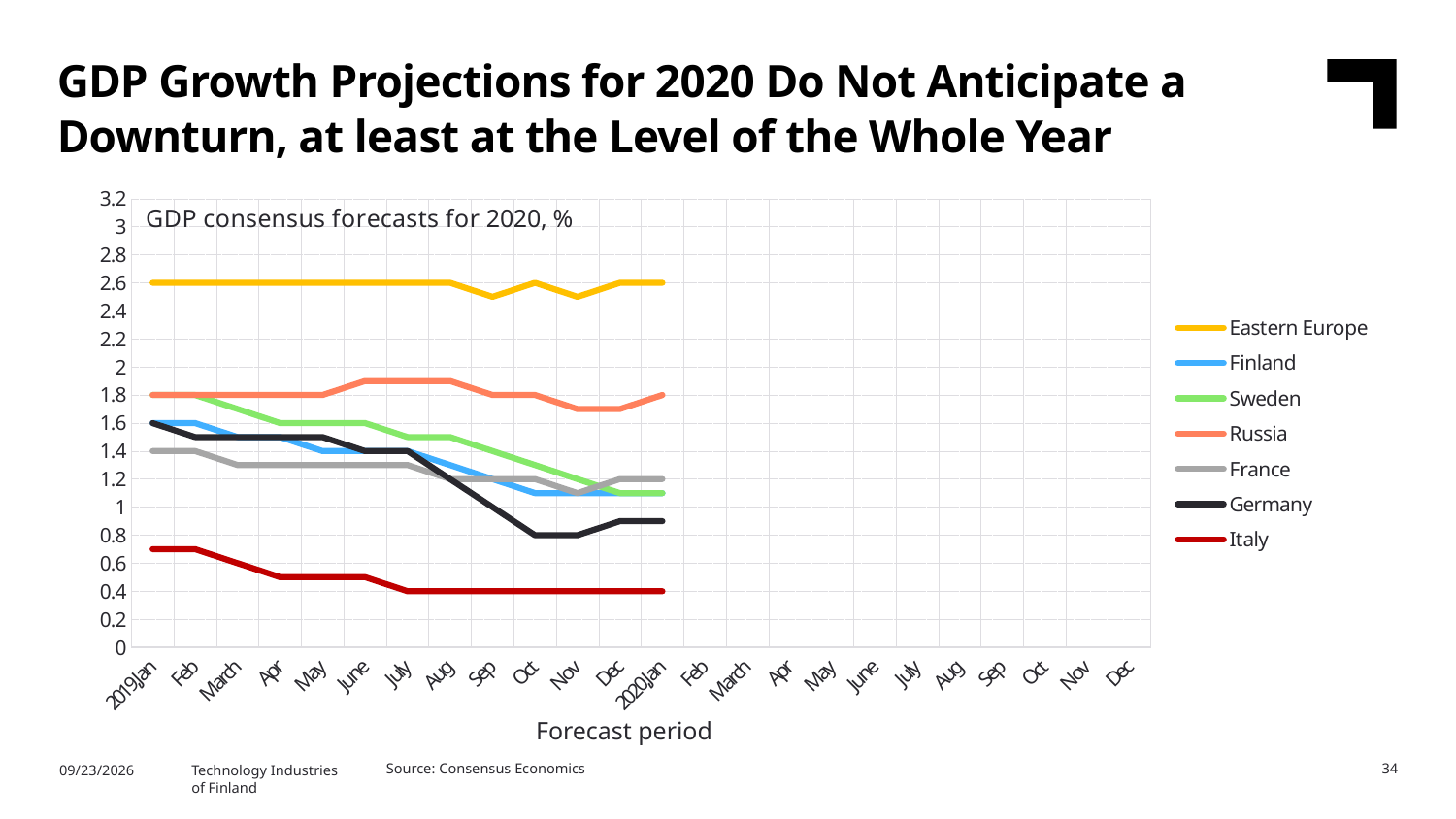
Is the value for Germany in 2020 Jan greater or less than 1? less Which series has the lowest forecast value in 2020 Jan? Italy What is the GDP growth forecast for Eastern Europe in 2019 Jan? 2.6 What is the GDP growth forecast for Germany in Oct 2019? 0.8 What is the GDP growth forecast for Italy in Dec 2019? 0.4 What type of chart is shown on the slide? line chart What is the difference between the Eastern Europe and Russia forecasts in 2019 Jan? 0.8 Which series has the highest forecast value in 2019 Jan? Eastern Europe Does the forecast for Germany rise or fall from 2019 Jan to 2020 Jan? fall Which is larger in 2019 Jan, the forecast for Finland or for France? Finland What is the GDP growth forecast for Russia in 2019 Jan? 1.8 How many series does the legend list? 7